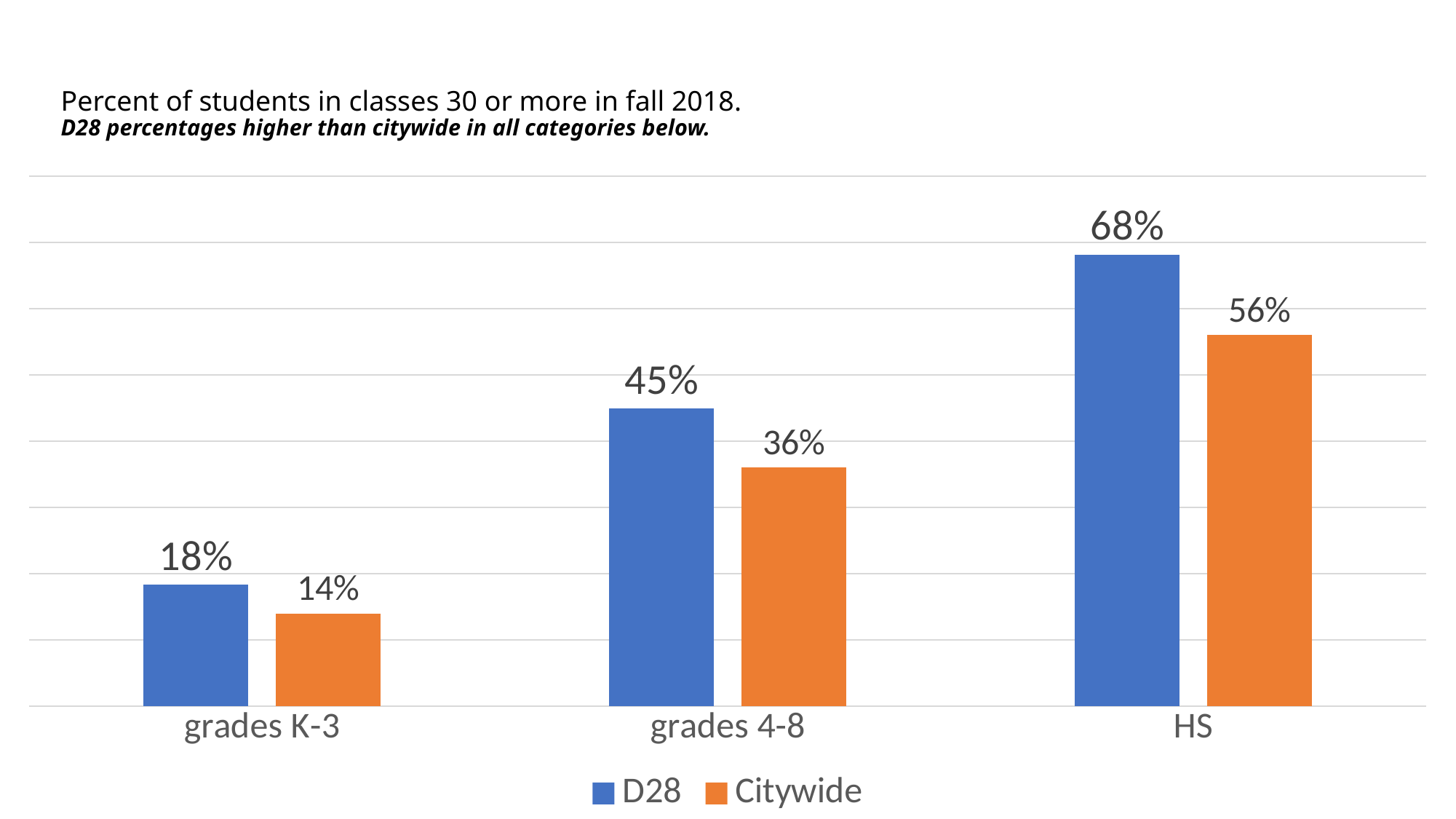
What is the Citywide value for HS? 56% How many series does the legend list? 2 How many categories are shown on the x axis? 3 Which category has the highest D28 value? HS What is the difference between the D28 and Citywide values for HS? 12% What is the D28 value for HS? 68% Which is larger for grades K-3, D28 or Citywide? D28 What kind of chart is shown on the slide? Bar chart Which category has the lowest Citywide value? grades K-3 What is the difference between the D28 and Citywide values for grades 4-8? 9% What is the Citywide value for grades 4-8? 36% What is the D28 value for grades K-3? 18%